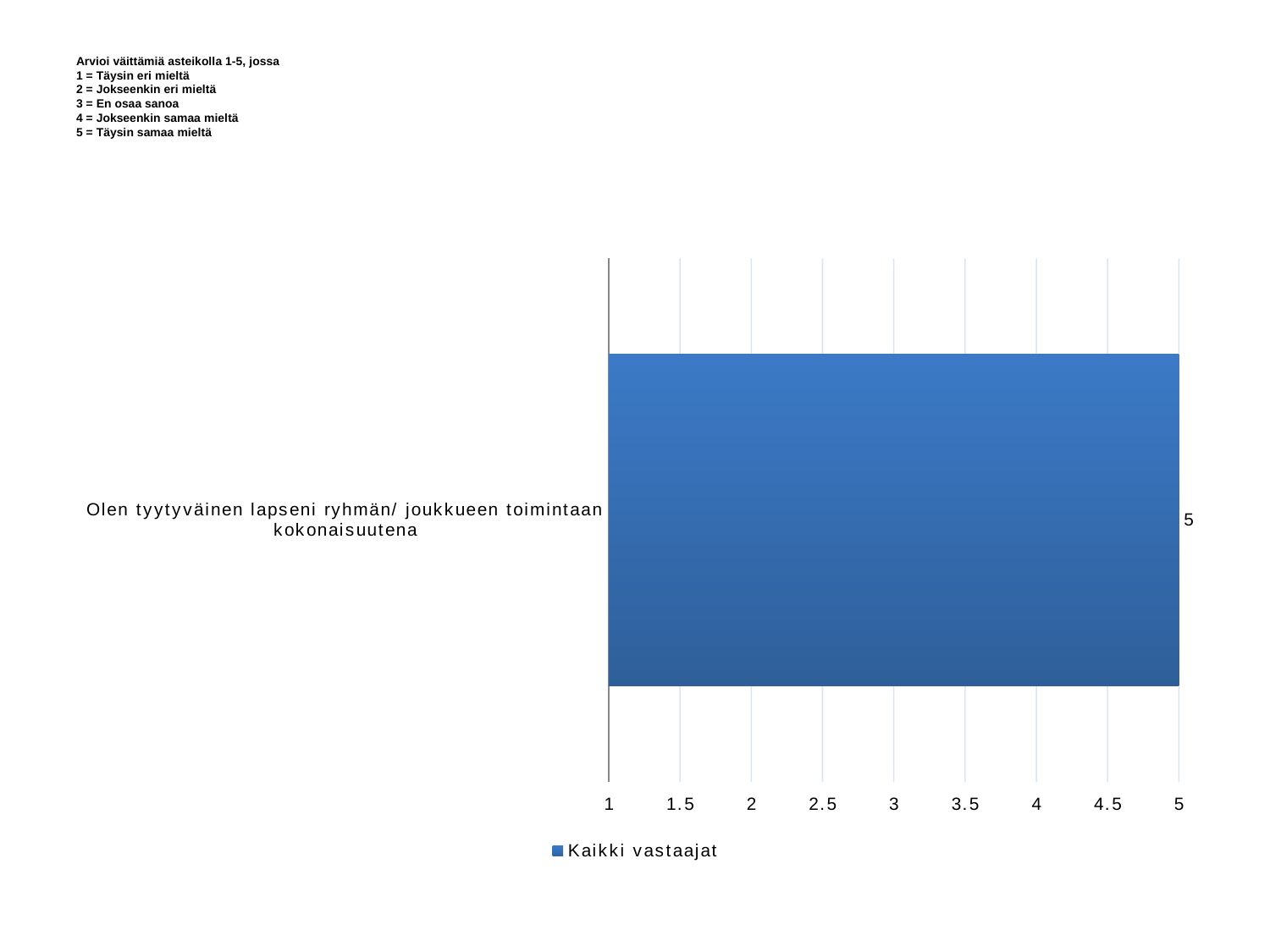
What is the value for "Olen tyytyväinen lapseni ryhmän/ joukkueen toimintaan kokonaisuutena"? 5 What kind of chart is shown on the slide? bar chart What is the highest value shown on the x axis? 5 How many categories are plotted in the chart? 1 Is the value for "Olen tyytyväinen lapseni ryhmän/ joukkueen toimintaan kokonaisuutena" greater or less than 4.5? greater What is the name of the series shown in the legend? Kaikki vastaajat How many series does the legend list? 1 Is the value for "Olen tyytyväinen lapseni ryhmän/ joukkueen toimintaan kokonaisuutena" greater or less than 3? greater